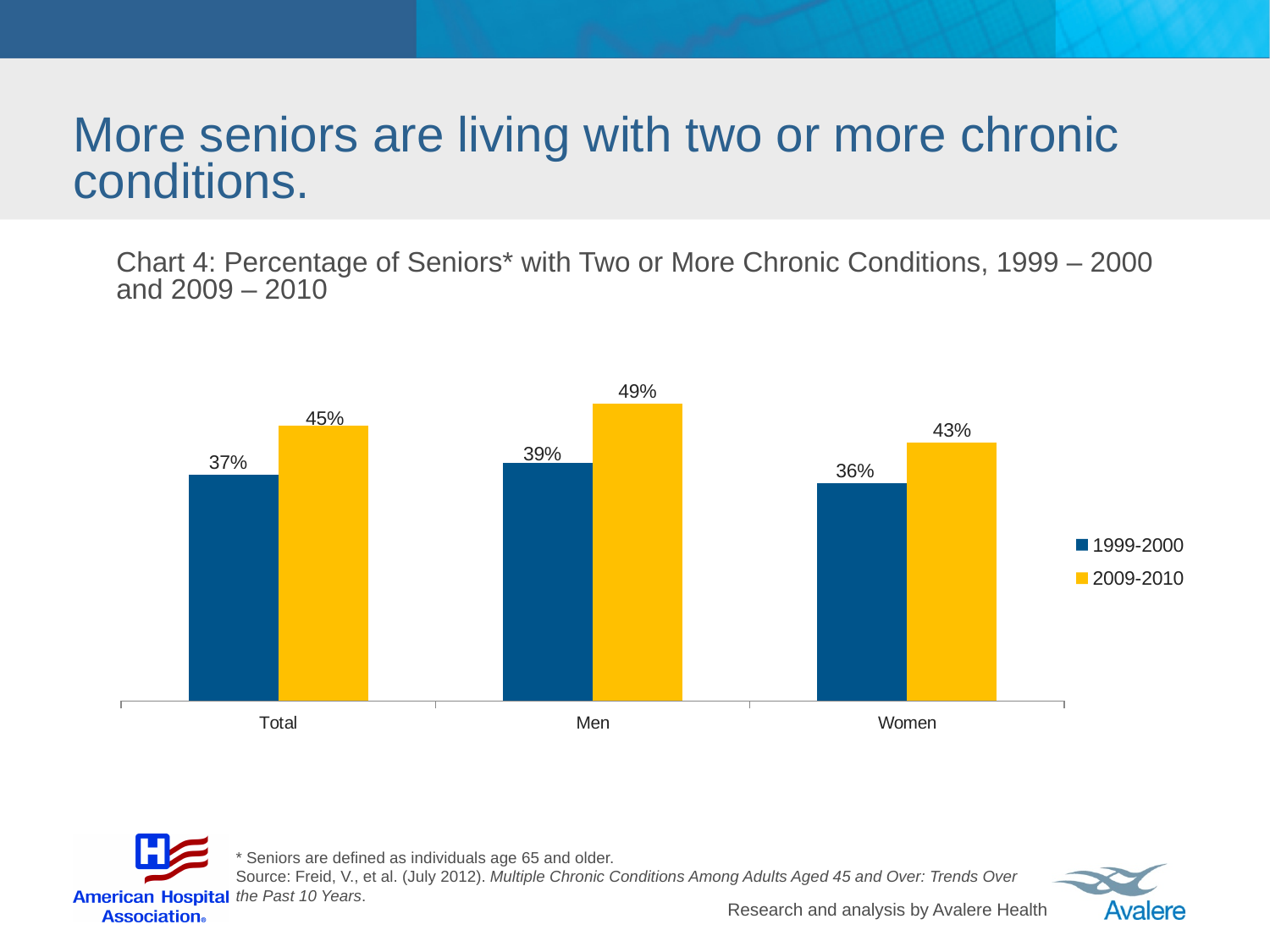
What is the value for Women in the 1999-2000 series? 36% Which is larger for Women: the 1999-2000 value or the 2009-2010 value? 2009-2010 What is the difference between the 2009-2010 and 1999-2000 values for Men? 10% How many series does the legend list? 2 Which category has the highest value in the 2009-2010 series? Men Which category has the lowest value in the 1999-2000 series? Women What is the value for Total in the 1999-2000 series? 37% What is the difference between the 2009-2010 and 1999-2000 values for Total? 8% What is the value for Women in the 2009-2010 series? 43% How many categories are shown on the x axis? 3 What is the value for Men in the 2009-2010 series? 49% What kind of chart is shown on the slide? Bar chart